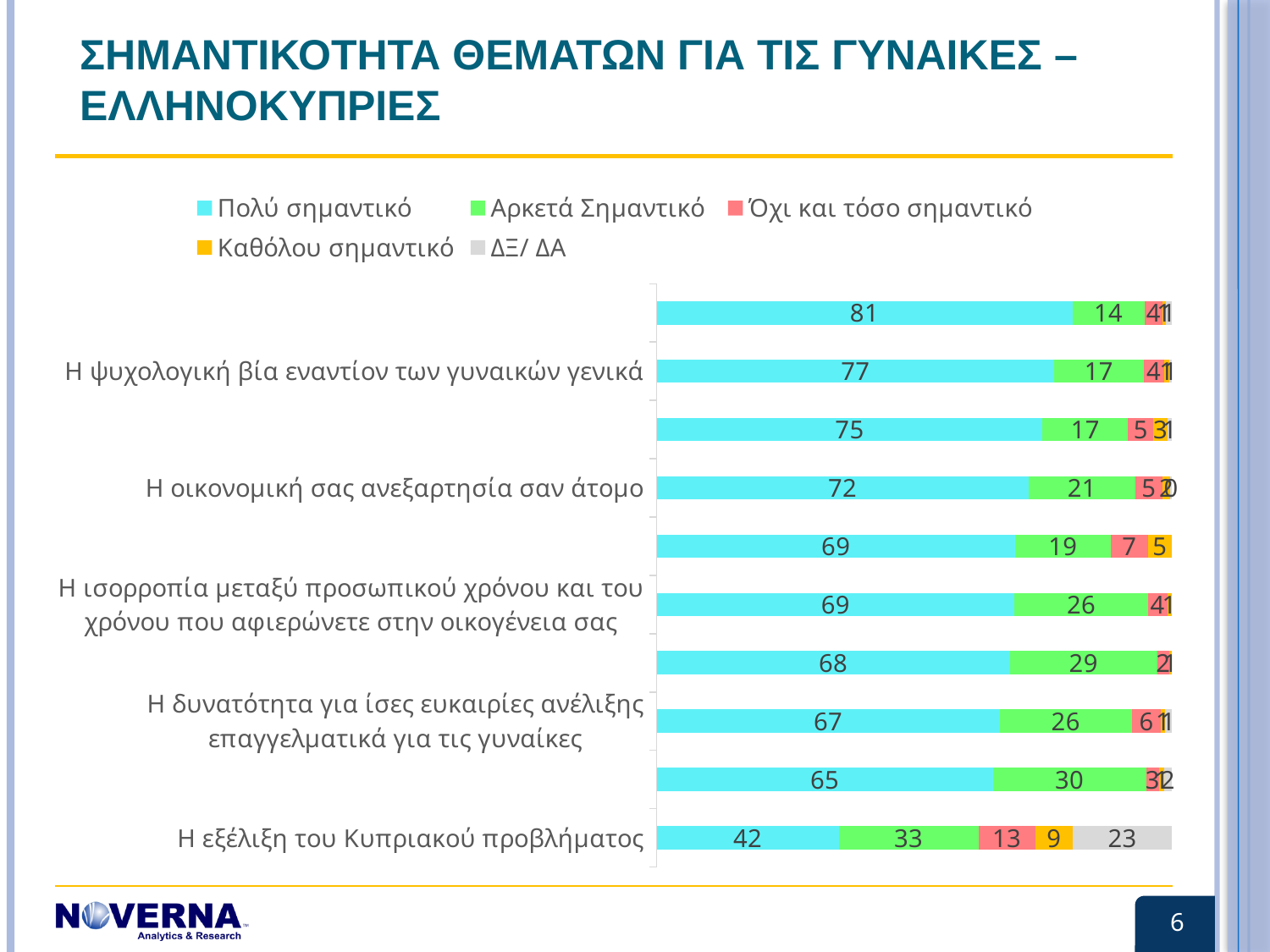
What is the 'Πολύ σημαντικό' value for 'Η οικονομική σας ανεξαρτησία σαν άτομο'? 72 What is the difference between the 'Πολύ σημαντικό' values for 'Η ψυχολογική βία εναντίον των γυναικών γενικά' and 'Η οικονομική σας ανεξαρτησία σαν άτομο'? 5 What is the 'ΔΞ/ΔΑ' value for 'Η εξέλιξη του Κυπριακού προβλήματος'? 23 What is the 'Αρκετά Σημαντικό' value for 'Η δυνατότητα για ίσες ευκαιρίες ανέλιξης επαγγελματικά για τις γυναίκες'? 26 What is the highest 'Πολύ σημαντικό' value shown in the chart? 81 How many bars are plotted in the chart? 10 What kind of chart is shown on the slide? bar chart Which has a larger 'Αρκετά Σημαντικό' value: 'Η εξέλιξη του Κυπριακού προβλήματος' or 'Η ψυχολογική βία εναντίον των γυναικών γενικά'? Η εξέλιξη του Κυπριακού προβλήματος What is the 'Πολύ σημαντικό' value for 'Η ψυχολογική βία εναντίον των γυναικών γενικά'? 77 How many series does the legend list? 5 What is the 'Όχι και τόσο σημαντικό' value for 'Η εξέλιξη του Κυπριακού προβλήματος'? 13 Which labelled category has the lowest 'Πολύ σημαντικό' value? Η εξέλιξη του Κυπριακού προβλήματος